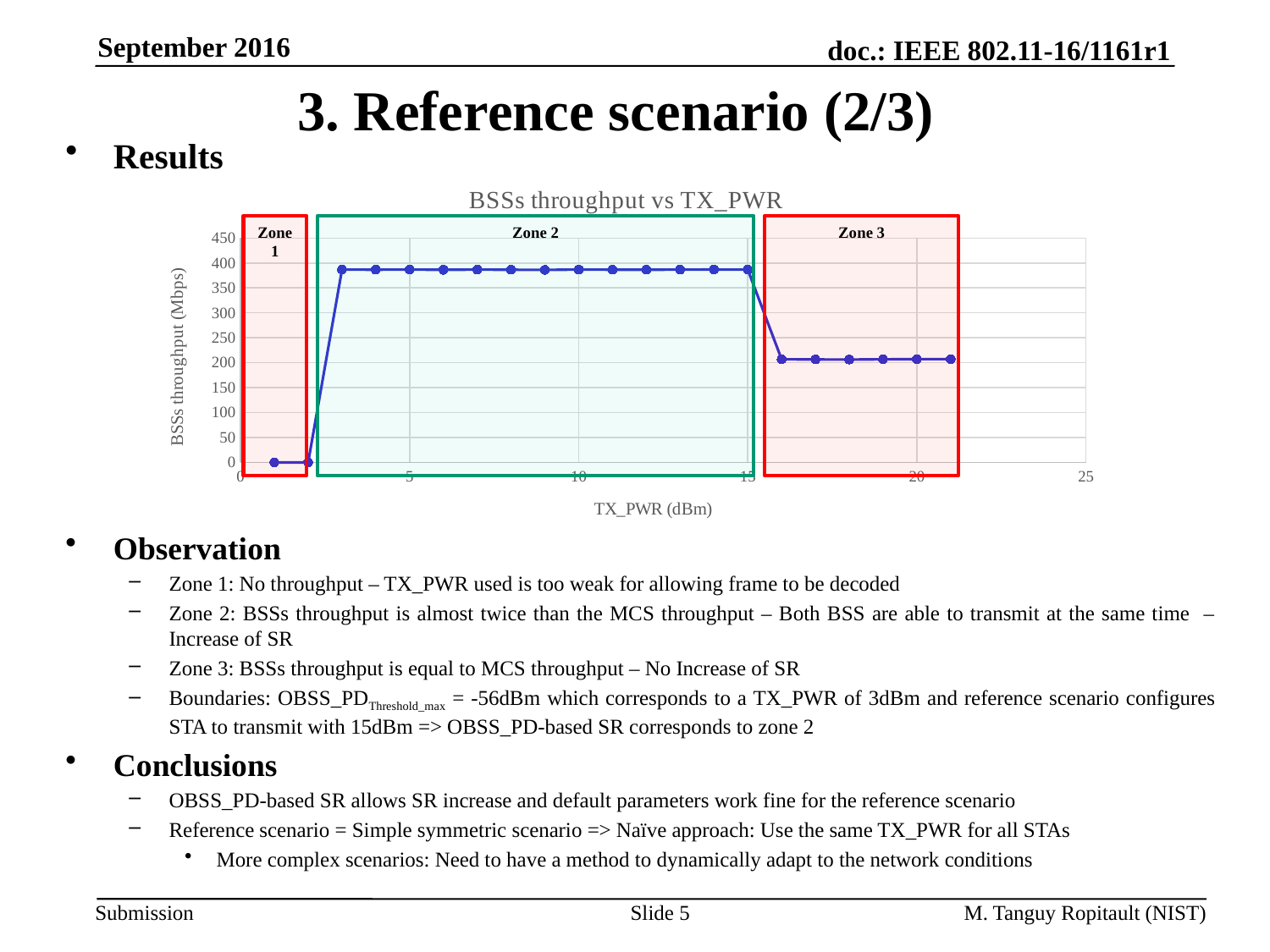
Which has the higher BSSs throughput: TX_PWR of 10 dBm or TX_PWR of 20 dBm? 10 dBm Is the BSSs throughput at a TX_PWR of 20 dBm greater or less than 250 Mbps? less Which zone has the highest BSSs throughput? Zone 2 Is the BSSs throughput at a TX_PWR of 18 dBm greater or less than 150 Mbps? greater How many zones are marked on the chart? 3 What is the title of the chart? BSSs throughput vs TX_PWR Which zone has the lowest BSSs throughput? Zone 1 Does the BSSs throughput rise or fall when TX_PWR goes from 15 dBm to 16 dBm? fall Does the BSSs throughput rise or fall when TX_PWR goes from 2 dBm to 3 dBm? rise What kind of chart is shown on the slide? line chart What is the BSSs throughput at a TX_PWR of 1 dBm? 0 Is the BSSs throughput at a TX_PWR of 10 dBm greater or less than 350 Mbps? greater